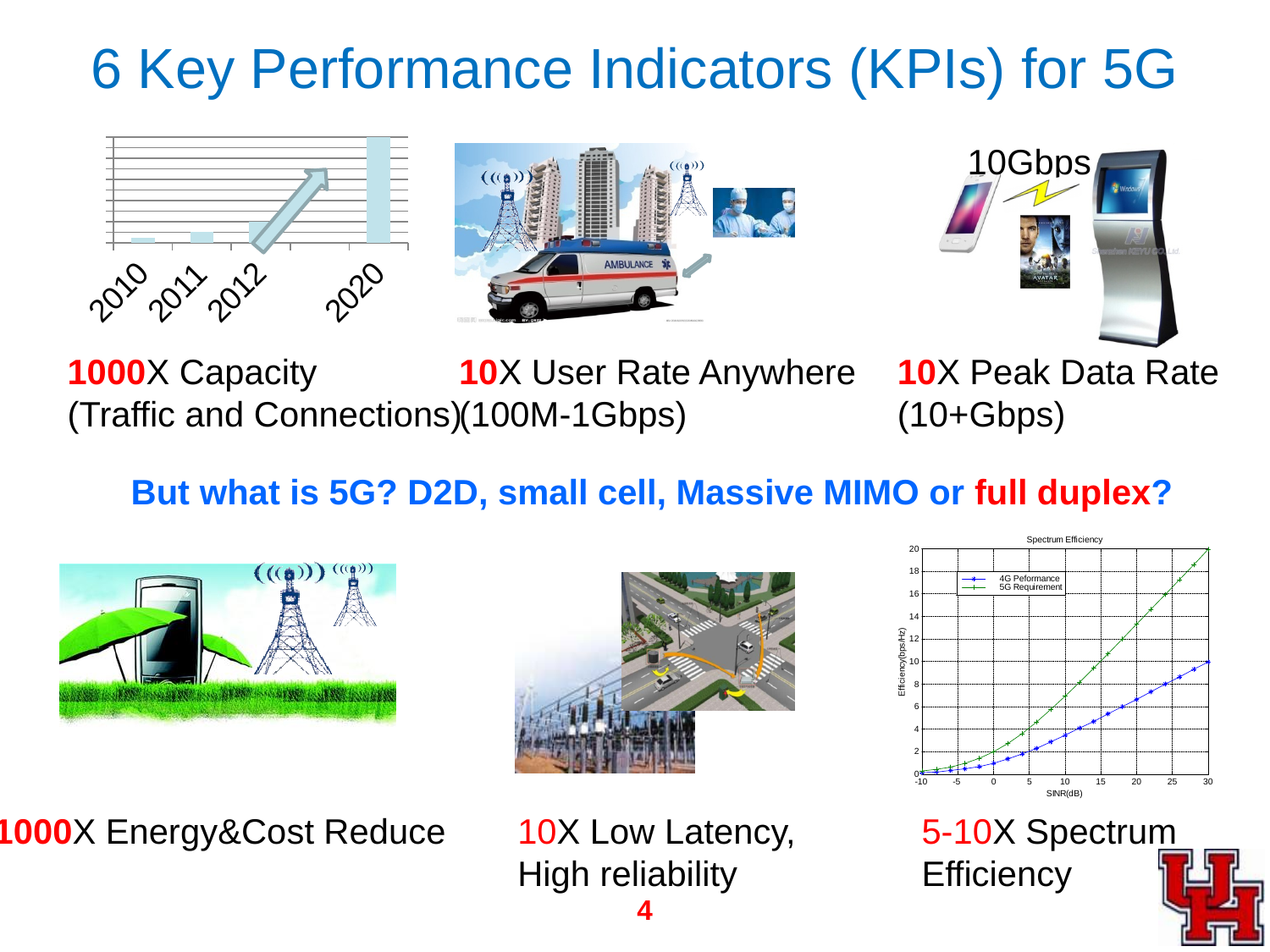
What is the title of the chart in the bottom-right of the slide? Spectrum Efficiency In the top-left bar chart, which year has the tallest bar? 2020 What kind of chart is the 'Spectrum Efficiency' chart? line chart In the 'Spectrum Efficiency' chart, is the 4G Peformance value at an SINR of 20 dB greater or less than 10? less In the top-left bar chart, which year has the shortest bar? 2010 In the 'Spectrum Efficiency' chart, is the 5G Requirement value at an SINR of 20 dB greater or less than 10? greater What kind of chart is the chart in the top-left of the slide, above the '1000X Capacity' label? bar chart In the top-left bar chart, do the bars rise or fall from 2010 to 2020? rise In the 'Spectrum Efficiency' chart, which series is higher at an SINR of 30 dB, 4G Peformance or 5G Requirement? 5G Requirement What are the two series named in the legend of the 'Spectrum Efficiency' chart? 4G Peformance and 5G Requirement In the top-left bar chart, how many years are shown on the x axis? 4 How many series does the legend of the 'Spectrum Efficiency' chart list? 2